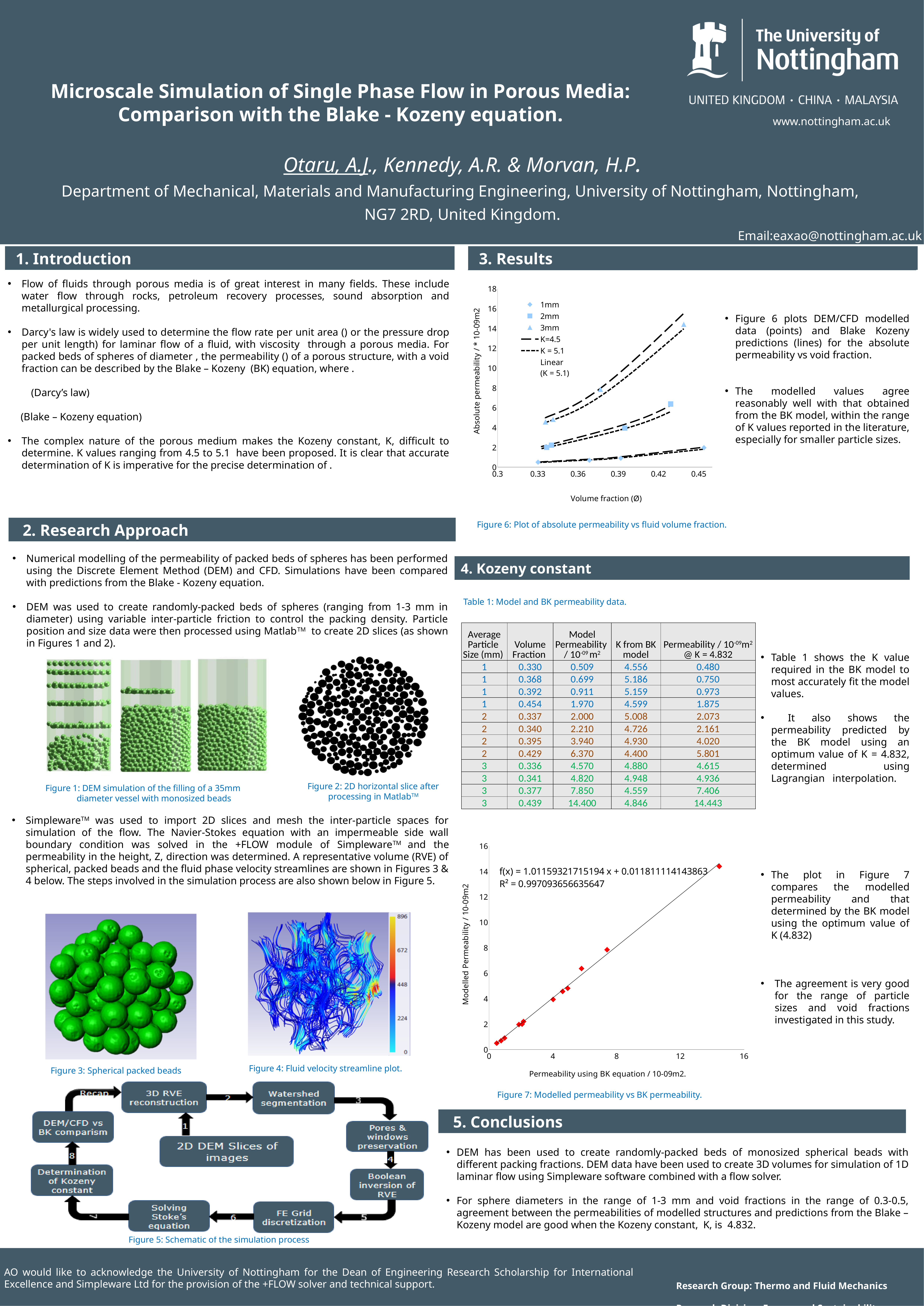
In Figure 6 (absolute permeability vs volume fraction), what kind of chart is shown? scatter chart In Figure 6, is the value of the 3mm point at the highest volume fraction greater or less than 12? greater In Figure 7, does the modelled permeability rise or fall as the BK permeability increases? rise In Figure 6, is the highest 1mm point greater or less than 4? less In Figure 6, how many entries does the legend list? 6 In Figure 6, do the absolute permeability values rise or fall as the volume fraction increases? rise In Figure 7 (modelled permeability vs BK permeability), what kind of chart is shown? scatter chart In Figure 7, what R² value is printed for the fitted line? 0.997093656635647 In Figure 6, which particle size series has the lowest absolute permeability values? 1mm In Figure 6, which particle size series has the highest absolute permeability values? 3mm In Figure 6, what is the label of the x axis? Volume fraction (Ø) In Figure 7, what is the slope of the fitted line f(x) printed on the chart? 1.01159321715194